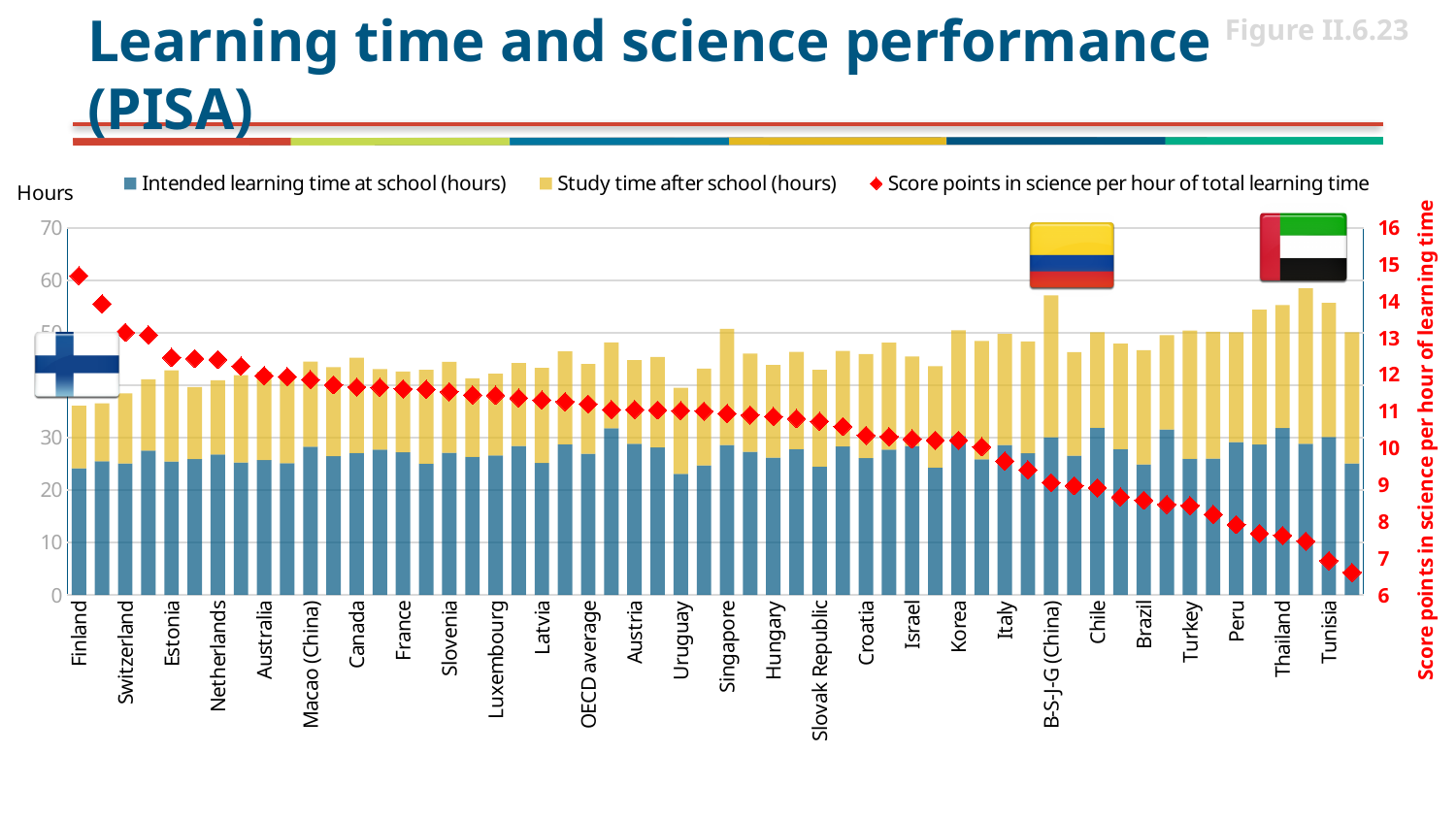
What is the label of the left vertical axis? Hours Is the total learning time (stacked bar) for Finland greater or less than 40 hours? less How many series does the legend list? 3 Is the total learning time (stacked bar) for Thailand greater or less than 50 hours? greater Which has the taller total stacked bar, Finland or Tunisia? Tunisia Which series is shown with red diamond markers? Score points in science per hour of total learning time Which labelled country has the lowest score points in science per hour of total learning time? Tunisia What kind of chart is shown on the slide? A combined stacked bar and line (marker) chart Is the value of score points in science per hour of total learning time for Finland greater or less than 14? greater Which labelled country has the highest score points in science per hour of total learning time? Finland Do the score points in science per hour of total learning time rise or fall from left to right across the countries? Fall